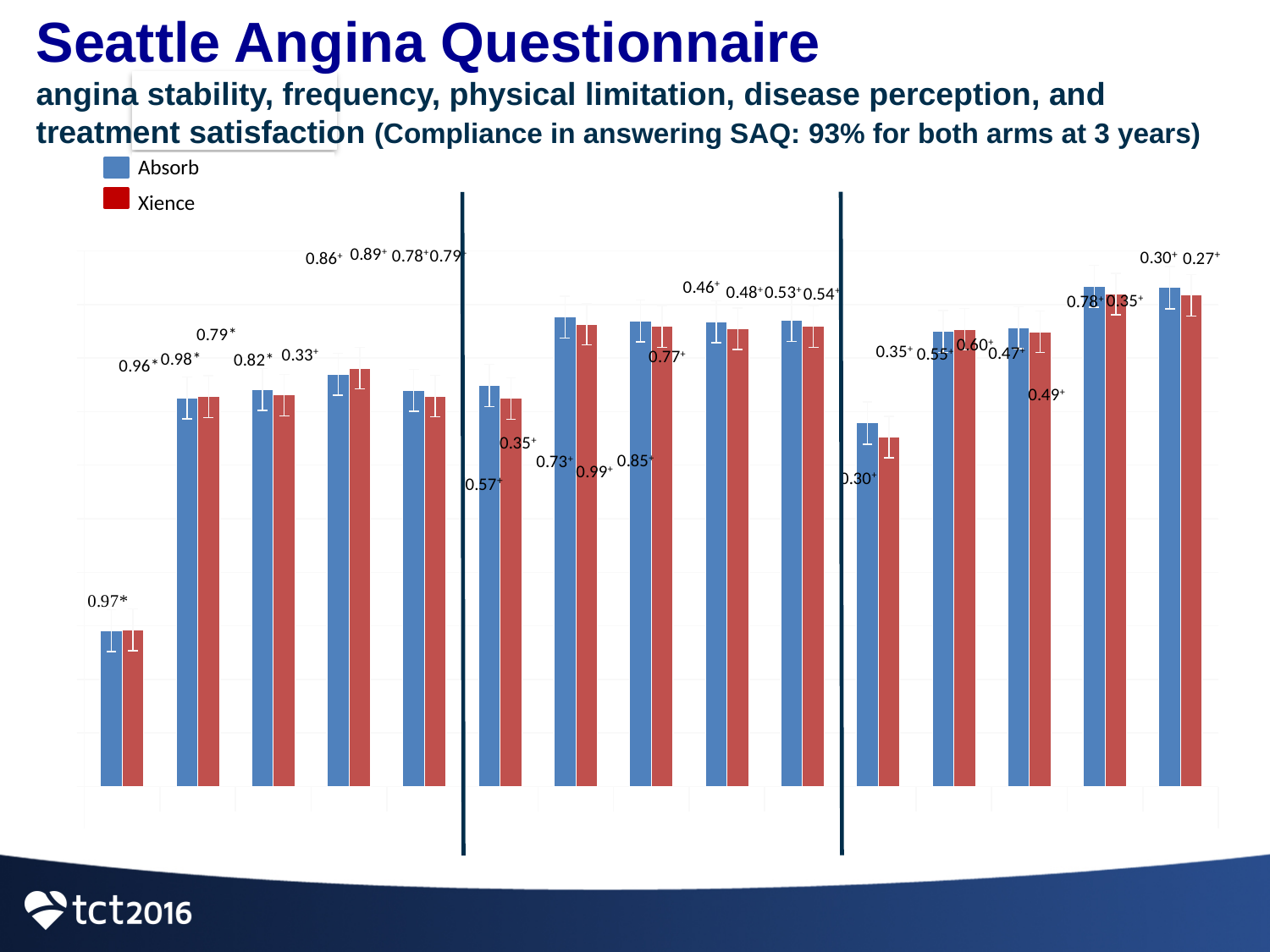
What are the two series named in the legend? Absorb and Xience How many series does the legend list? 2 What kind of chart is shown on the slide? bar chart How many groups of paired bars are plotted in the chart? 15 In the fourth group of bars from the left, which series has the taller bar, Absorb or Xience? Xience In the first group of bars to the right of the second vertical divider line, which series has the taller bar, Absorb or Xience? Absorb What is the title of the slide containing the chart? Seattle Angina Questionnaire Which group of bars is the lowest in the chart? the leftmost (first) group